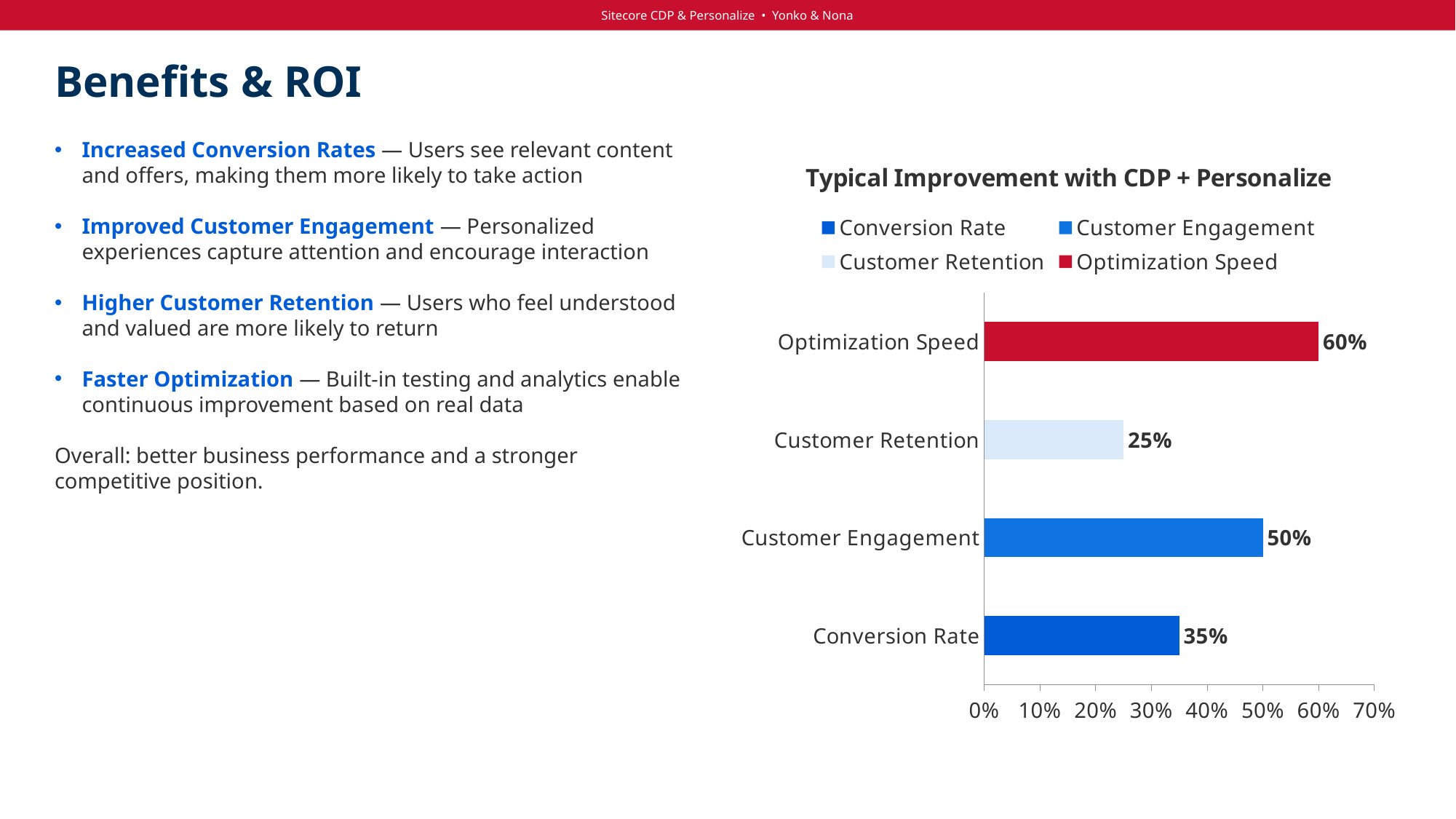
What is the title of the chart? Typical Improvement with CDP + Personalize How many categories are shown in the chart? 4 Which is larger, the value for Conversion Rate or the value for Customer Engagement? Customer Engagement What is the value for Customer Engagement? 50% What kind of chart is shown on the slide? Bar chart Which category has the lowest value? Customer Retention Which category has the highest value? Optimization Speed What is the value for Customer Retention? 25% What is the value for Optimization Speed? 60% What is the difference between the values for Customer Engagement and Conversion Rate? 15% What is the value for Conversion Rate? 35% What is the difference between the values for Optimization Speed and Customer Retention? 35%